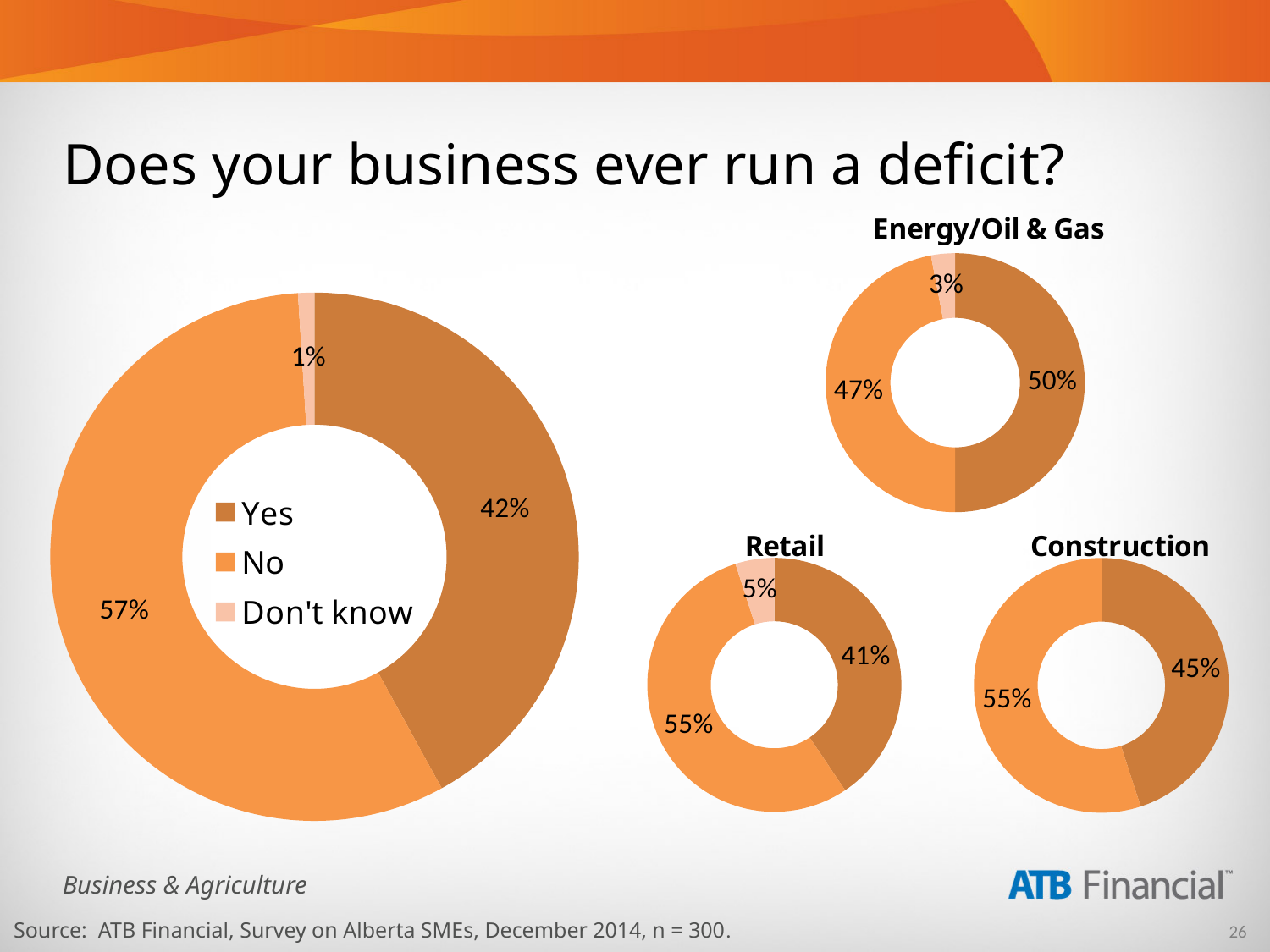
What kind of chart is used on this slide? Pie (donut) chart On the Retail chart, what percentage answered "No"? 55% On the Energy/Oil & Gas chart, what percentage answered "Don't know"? 3% On the Retail chart, which response has the smallest share? Don't know On the Energy/Oil & Gas chart, which is larger, the "Yes" share or the "No" share? Yes On the large chart on the left, what percentage of respondents answered "No"? 57% On the Energy/Oil & Gas chart, what percentage answered "Yes"? 50% On the Construction chart, what percentage answered "Yes"? 45% How many series does the legend on the large chart list? 3 On the large chart on the left, what percentage answered "Don't know"? 1% On the large chart on the left, what percentage of respondents answered "Yes"? 42% On the large chart on the left, what is the difference between the "No" and "Yes" shares? 15 percentage points